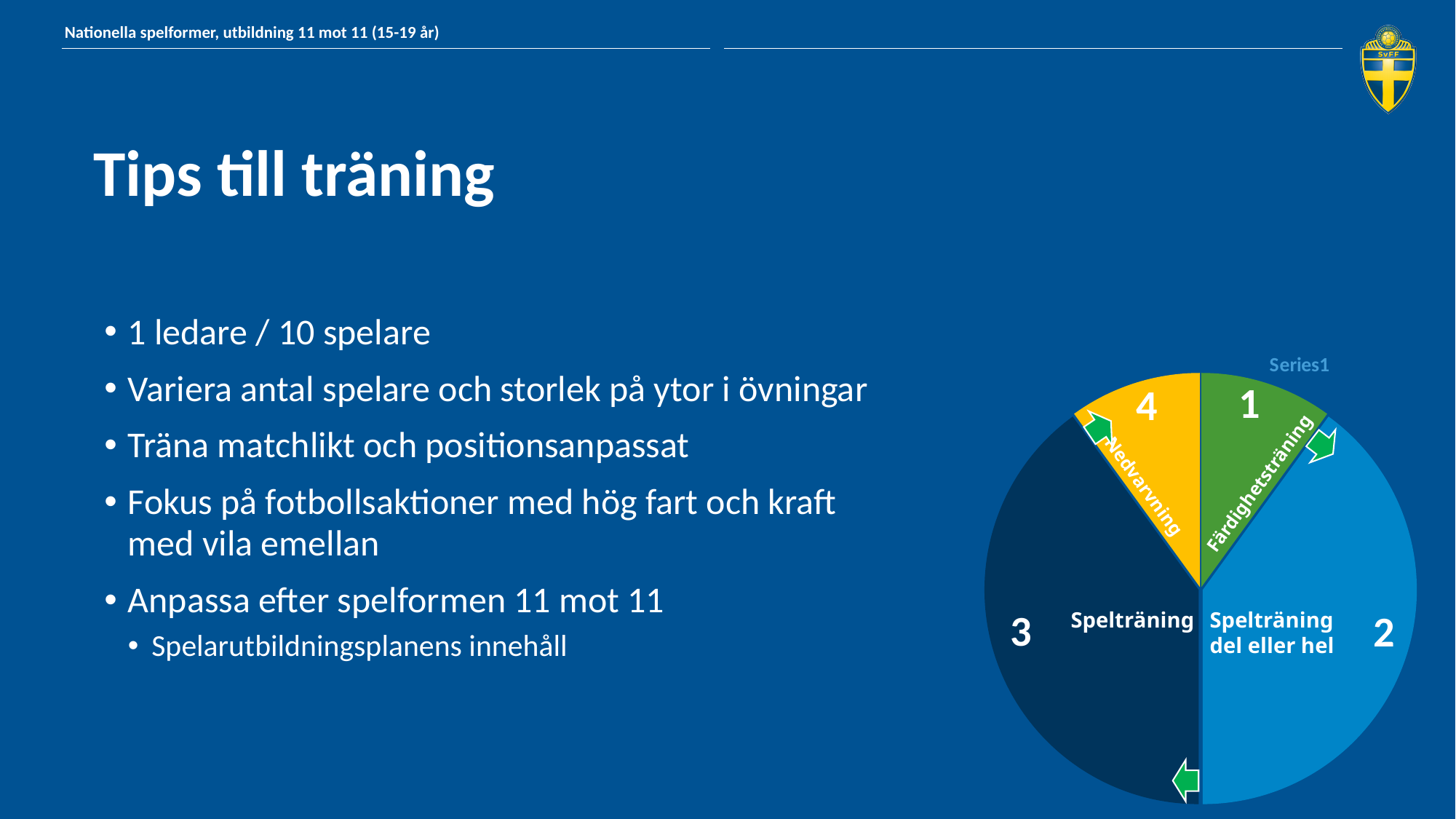
Which slice of the pie chart is the smallest? Färdighetsträning and Nedvarvning (they are equally small) Which slice is larger in the pie chart, Nedvarvning or Färdighetsträning? Neither; they are the same size Which slice is larger in the pie chart, Spelträning del eller hel or Nedvarvning? Spelträning del eller hel Which slice is larger in the pie chart, Spelträning (3) or Färdighetsträning (1)? Spelträning Which slice of the pie chart is labelled with the number 4? Nedvarvning What kind of chart is shown on the slide? pie chart How many slices does the pie chart have? 4 Which slice of the pie chart is labelled with the number 1? Färdighetsträning